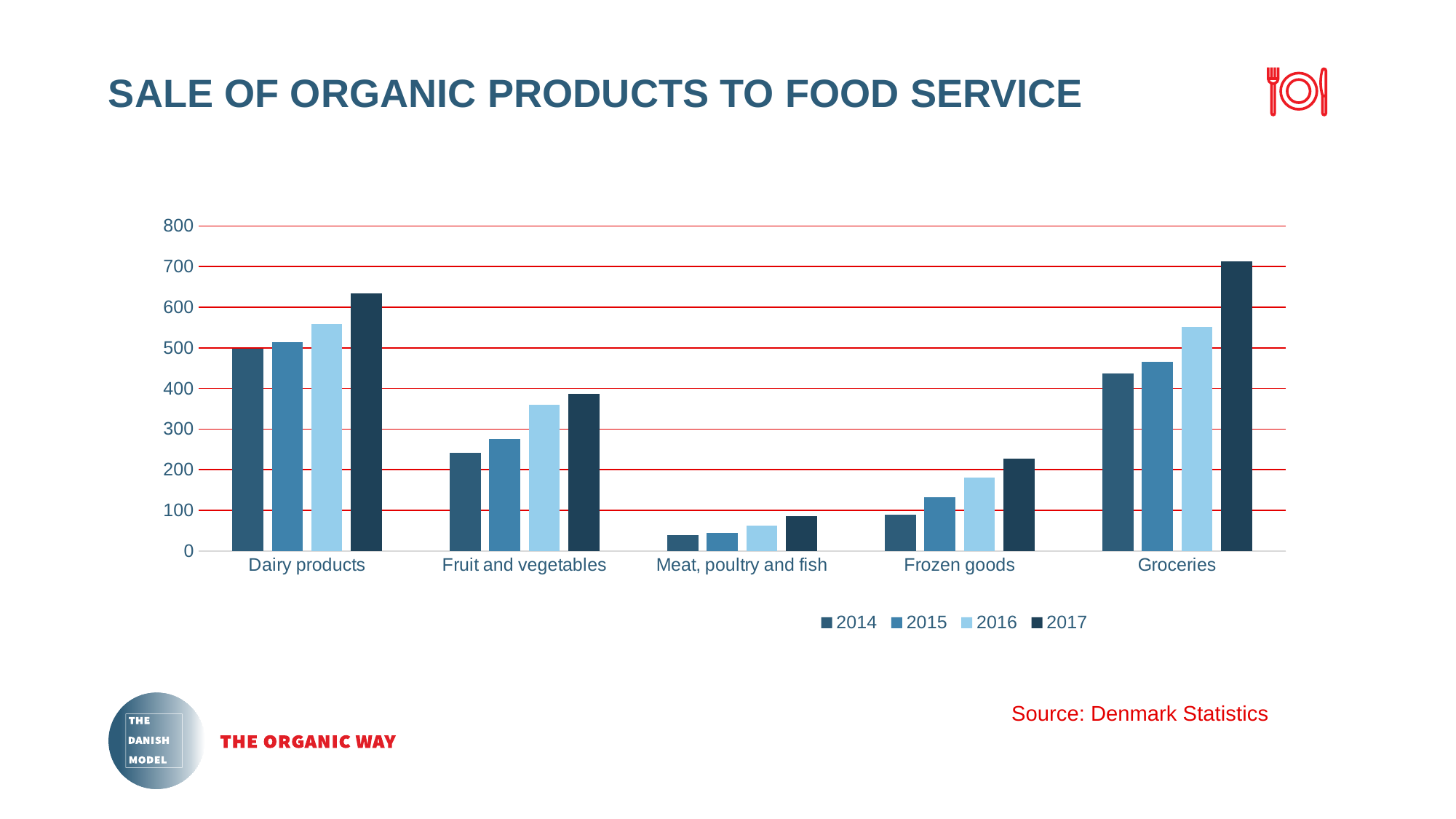
Which category has the lowest value for 2014? Meat, poultry and fish Is the value for Fruit and vegetables in 2016 greater or less than 300? greater How many product categories are shown on the x axis? 5 Which category has the highest value for 2017? Groceries What is the title of the chart on the slide? SALE OF ORGANIC PRODUCTS TO FOOD SERVICE How many series does the legend list? 4 Is the value for Meat, poultry and fish in 2017 greater or less than 100? less Is the value for Groceries in 2017 greater or less than 600? greater What kind of chart is shown on the slide? Bar chart Which is larger, the 2017 value for Dairy products or the 2017 value for Groceries? Groceries Which years are listed in the legend? 2014, 2015, 2016, 2017 Within the Frozen goods category, do the values rise or fall from 2014 to 2017? rise